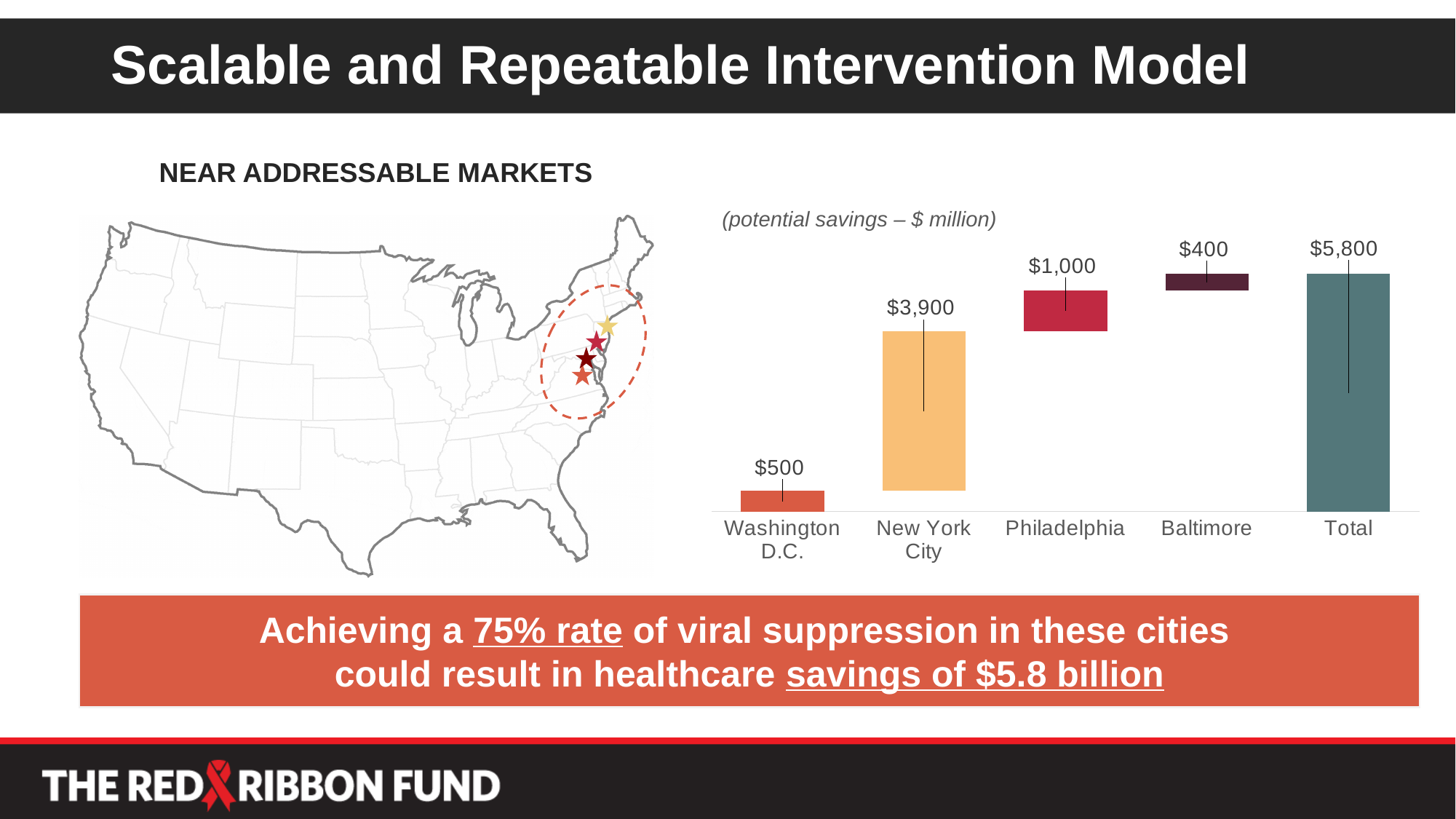
What kind of chart is used to show the potential savings? Bar chart What is the potential savings value shown for Washington D.C.? $500 What is the value shown for the Total bar? $5,800 What is the difference in potential savings between New York City and Philadelphia? $2,900 How many bars are shown in the chart, including the Total bar? 5 Which city has the highest potential savings? New York City What is the potential savings value shown for Baltimore? $400 What unit is stated for the potential savings in the chart? $ million What is the potential savings value shown for New York City? $3,900 Which has larger potential savings, Washington D.C. or Philadelphia? Philadelphia Which city has the lowest potential savings? Baltimore What is the combined potential savings of Washington D.C. and Baltimore? $900